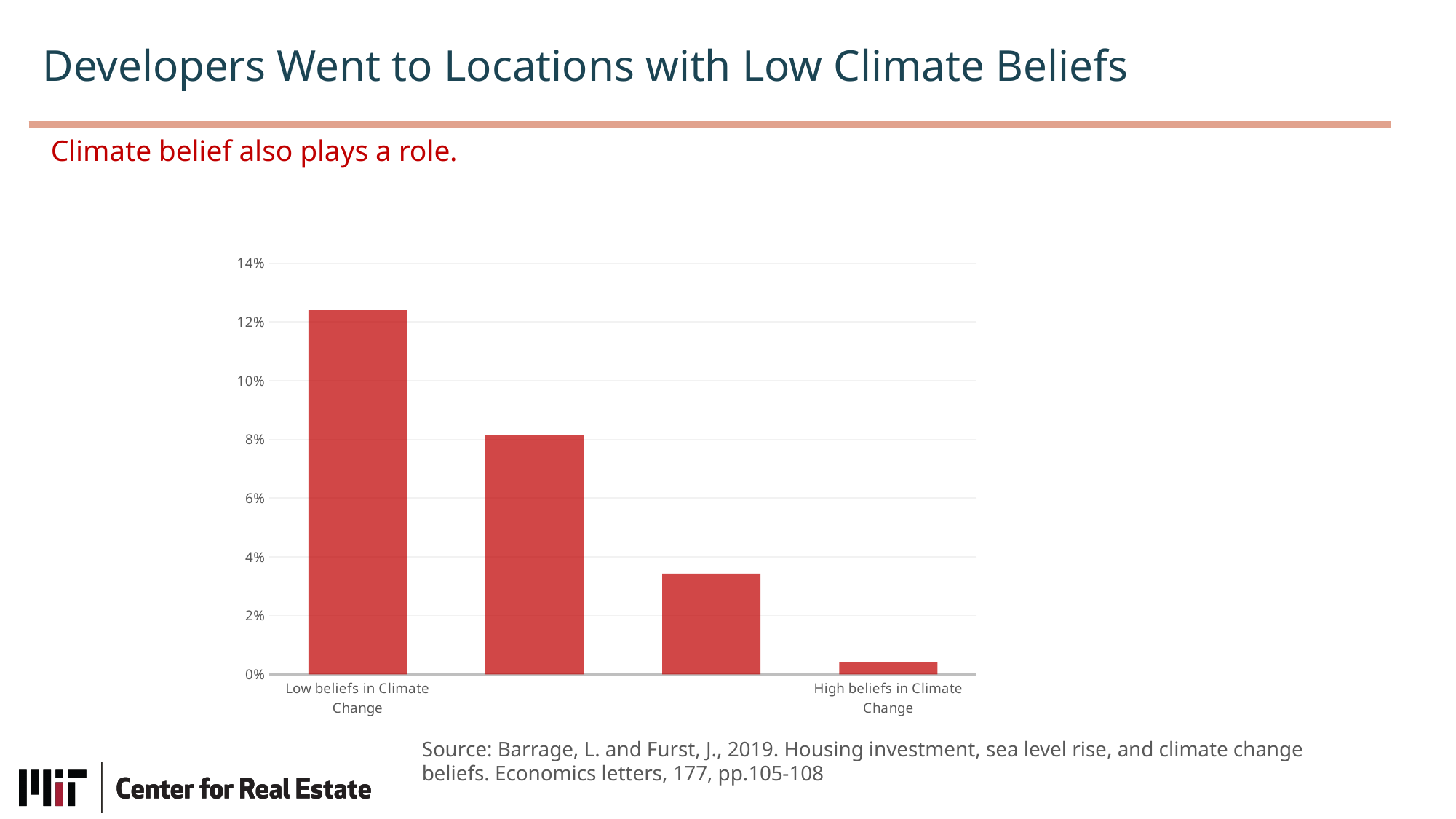
Which is larger, the value for Low beliefs in Climate Change or the value for High beliefs in Climate Change? Low beliefs in Climate Change Do the bar values rise or fall moving from left to right along the x axis? fall What is the highest value shown on the vertical axis? 14% Which labelled category has the lowest bar? High beliefs in Climate Change What is the title of the slide containing the chart? Developers Went to Locations with Low Climate Beliefs Is the value for Low beliefs in Climate Change greater or less than 10%? greater Is the value for High beliefs in Climate Change greater or less than 2%? less Which labelled category has the highest bar? Low beliefs in Climate Change What kind of chart is shown on the slide? bar chart How many bars are plotted in the chart? 4